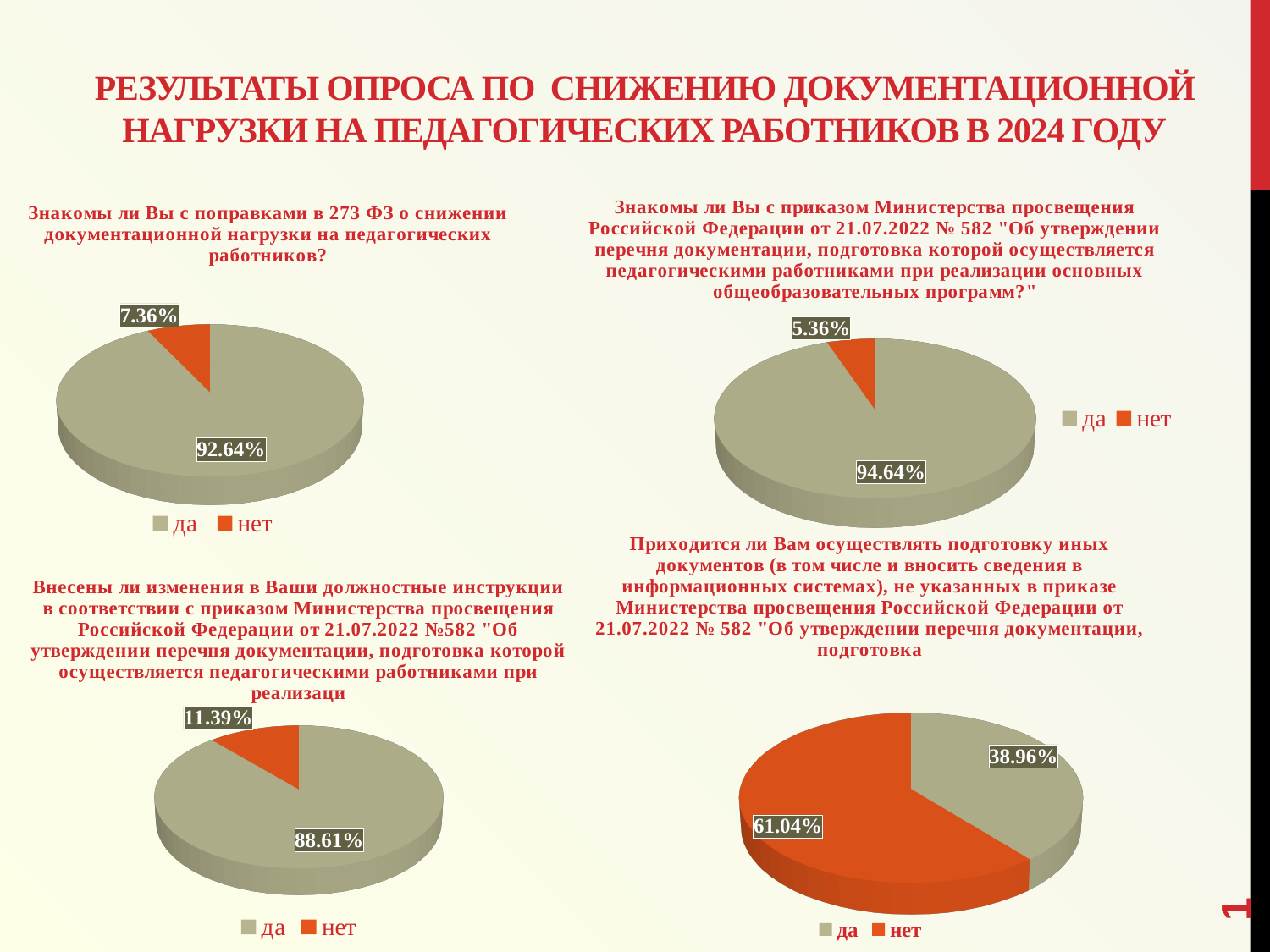
In the bottom-right pie chart, what is the difference between the "нет" share and the "да" share? 22.08% In the top-right pie chart, what is the value for "нет"? 5.36% In the bottom-left pie chart, what is the value for "да"? 88.61% In the top-left pie chart, what is the value for "нет"? 7.36% In the bottom-left pie chart, what is the value for "нет"? 11.39% In the bottom-right pie chart, which answer has the larger share, "да" or "нет"? нет How many pie charts are shown on the slide? 4 In the top-left pie chart, what share of respondents answered "да"? 92.64% What type of chart is used in the bottom-left of the slide? Pie chart In the top-right pie chart, what share of respondents answered "да"? 94.64% In the top-left pie chart, which answer has the smallest share? нет In the bottom-right pie chart, what share of respondents answered "нет"? 61.04%